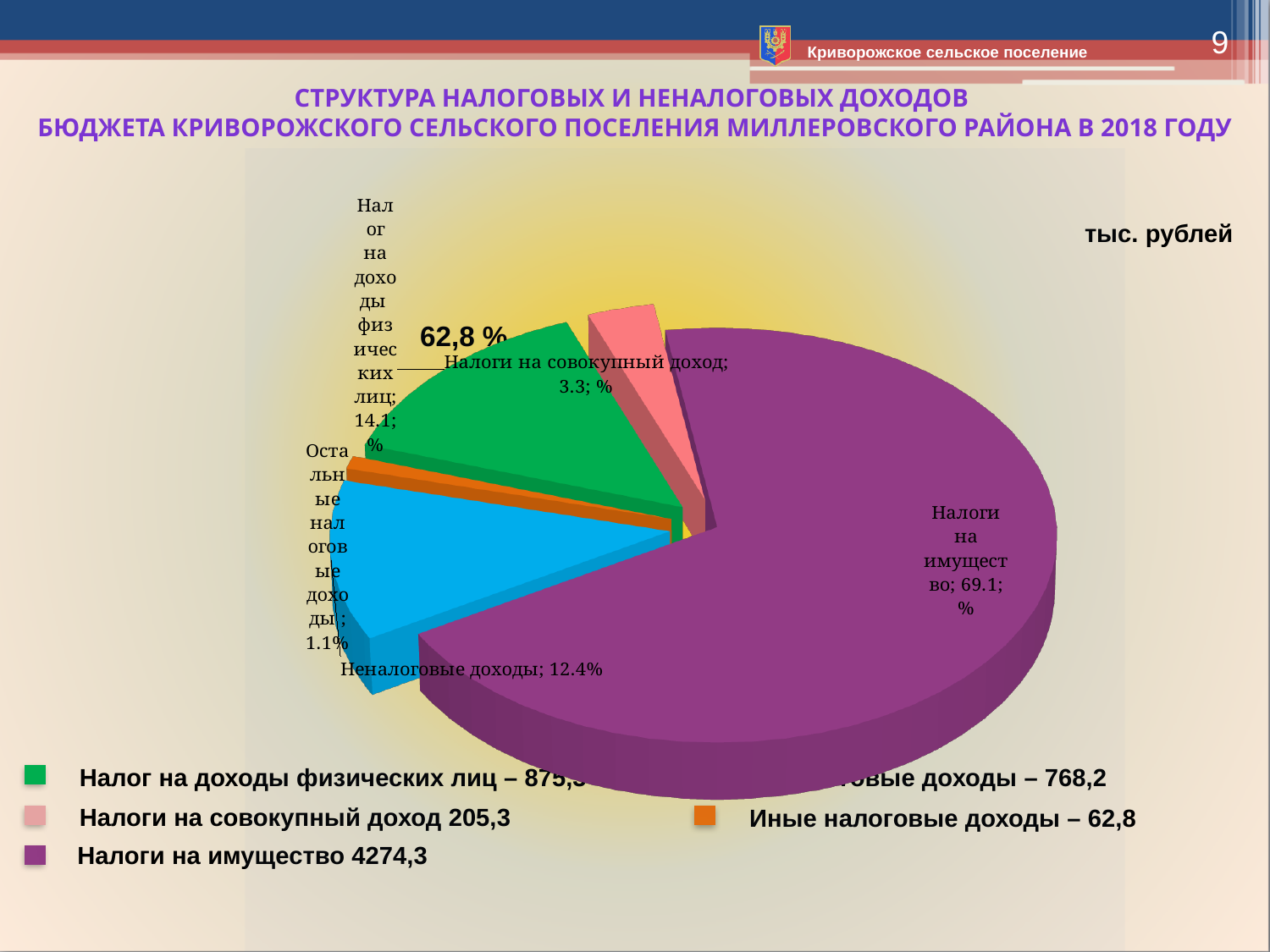
What share of the pie does "Налоги на имущество" represent? 69.1% What share of the pie does "Остальные налоговые доходы" represent? 1.1% According to the legend text, what is the value for "Налоги на имущество"? 4274,3 What share of the pie does "Налоги на совокупный доход" represent? 3.3% Which category has the largest slice of the pie? Налоги на имущество What type of chart is shown on the slide? pie chart Which category has the smallest slice of the pie? Остальные налоговые доходы Which slice is larger: "Неналоговые доходы" or "Налоги на совокупный доход"? Неналоговые доходы How many slices does the pie chart have? 5 In what units are the values on the chart given, according to the note on the slide? тыс. рублей